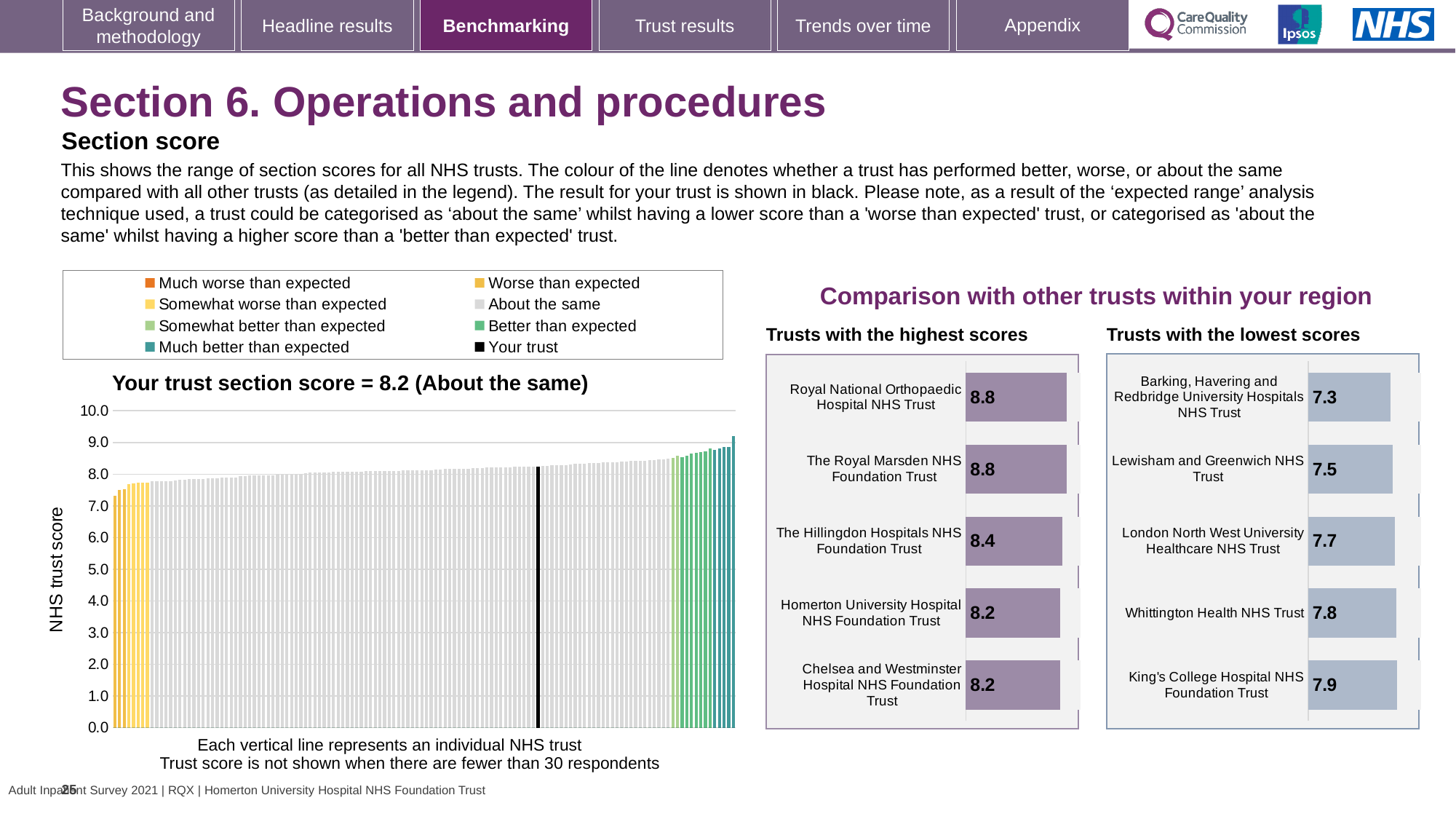
In the 'Trusts with the highest scores' chart, what is the difference between the scores of The Royal Marsden NHS Foundation Trust and The Hillingdon Hospitals NHS Foundation Trust? 0.4 In the 'Trusts with the highest scores' chart, what is the score for The Hillingdon Hospitals NHS Foundation Trust? 8.4 What kind of chart is the 'Your trust section score' chart on the left? bar chart How many trusts are shown in the 'Trusts with the highest scores' chart? 5 How many entries does the legend above the 'Your trust section score' chart list? 8 In the 'Trusts with the lowest scores' chart, which has the larger score: Lewisham and Greenwich NHS Trust or Whittington Health NHS Trust? Whittington Health NHS Trust In the 'Your trust section score' chart, what is the section score for your trust? 8.2 In the 'Your trust section score' chart, do the bars rise or fall from left to right? rise What is the y-axis label of the 'Your trust section score' chart? NHS trust score In the 'Trusts with the lowest scores' chart, what is the difference between the scores of King's College Hospital NHS Foundation Trust and Barking, Havering and Redbridge University Hospitals NHS Trust? 0.6 In the 'Trusts with the lowest scores' chart, which trust has the lowest score? Barking, Havering and Redbridge University Hospitals NHS Trust In the 'Your trust section score' chart, is the value of the leftmost (lowest) bar greater or less than 8.0? less